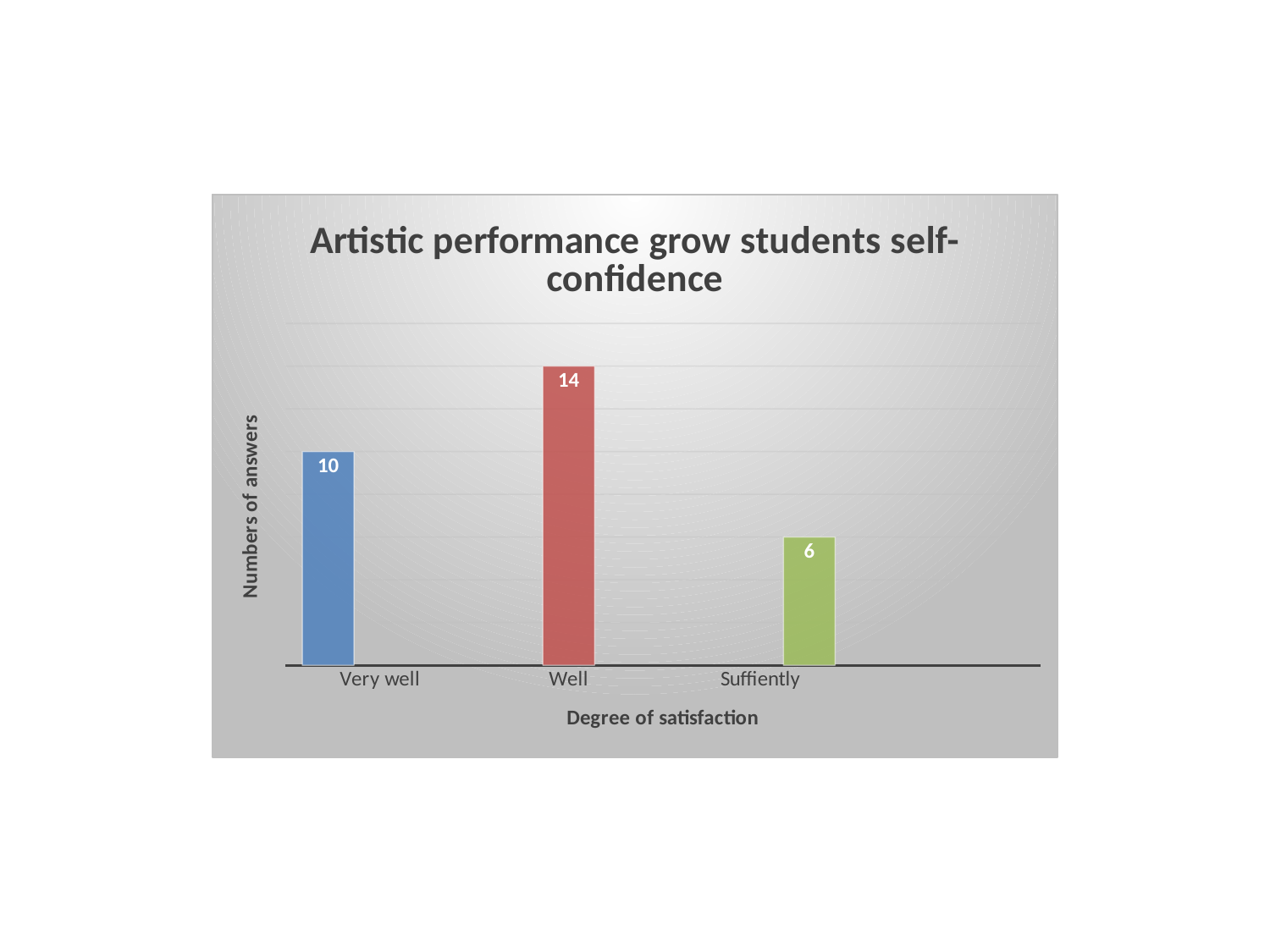
Which degree of satisfaction has the lowest number of answers? Suffiently What is the title of the chart? Artistic performance grow students self-confidence What is the number of answers for "Suffiently"? 6 What is the number of answers for "Well"? 14 What is the number of answers for "Very well"? 10 Which has more answers, "Very well" or "Suffiently"? Very well What is the label of the x axis? Degree of satisfaction How many categories are shown on the x axis? 3 Which degree of satisfaction has the highest number of answers? Well What is the difference between the number of answers for "Well" and "Very well"? 4 What kind of chart is shown on the slide? Bar chart What is the difference between the number of answers for "Very well" and "Suffiently"? 4